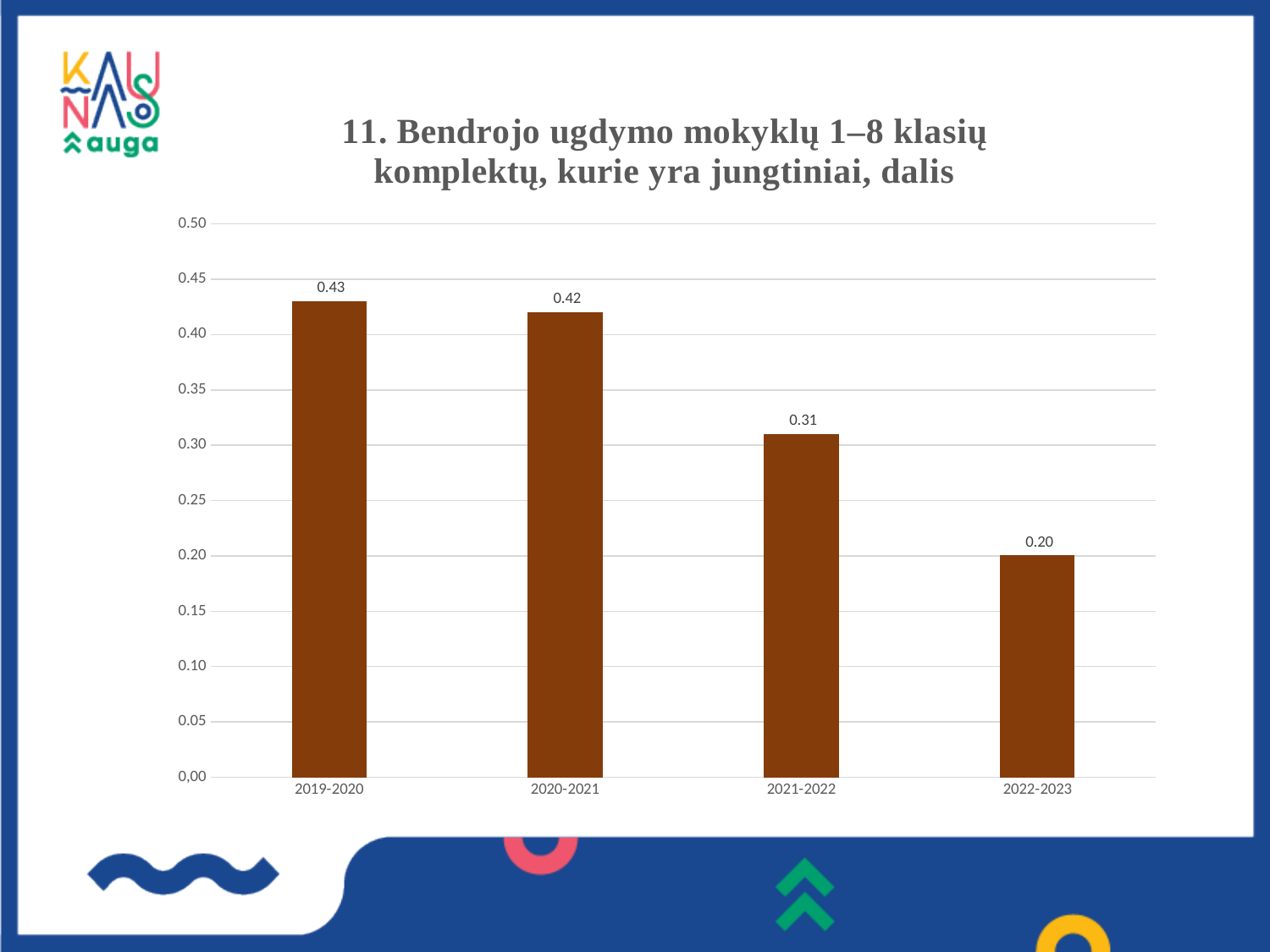
Which is larger, the value for 2020-2021 or the value for 2021-2022? 2020-2021 What is the value for 2021-2022? 0.31 What kind of chart is shown on the slide? bar chart Which school year has the highest value? 2019-2020 What is the highest value shown on the vertical axis? 0.50 What is the value for 2019-2020? 0.43 What is the difference between the values for 2020-2021 and 2022-2023? 0.22 Is the value for 2021-2022 greater or less than 0.35? less What is the value for 2022-2023? 0.20 Do the values rise or fall from 2019-2020 to 2022-2023? fall How many school years are shown on the chart? 4 Which school year has the lowest value? 2022-2023